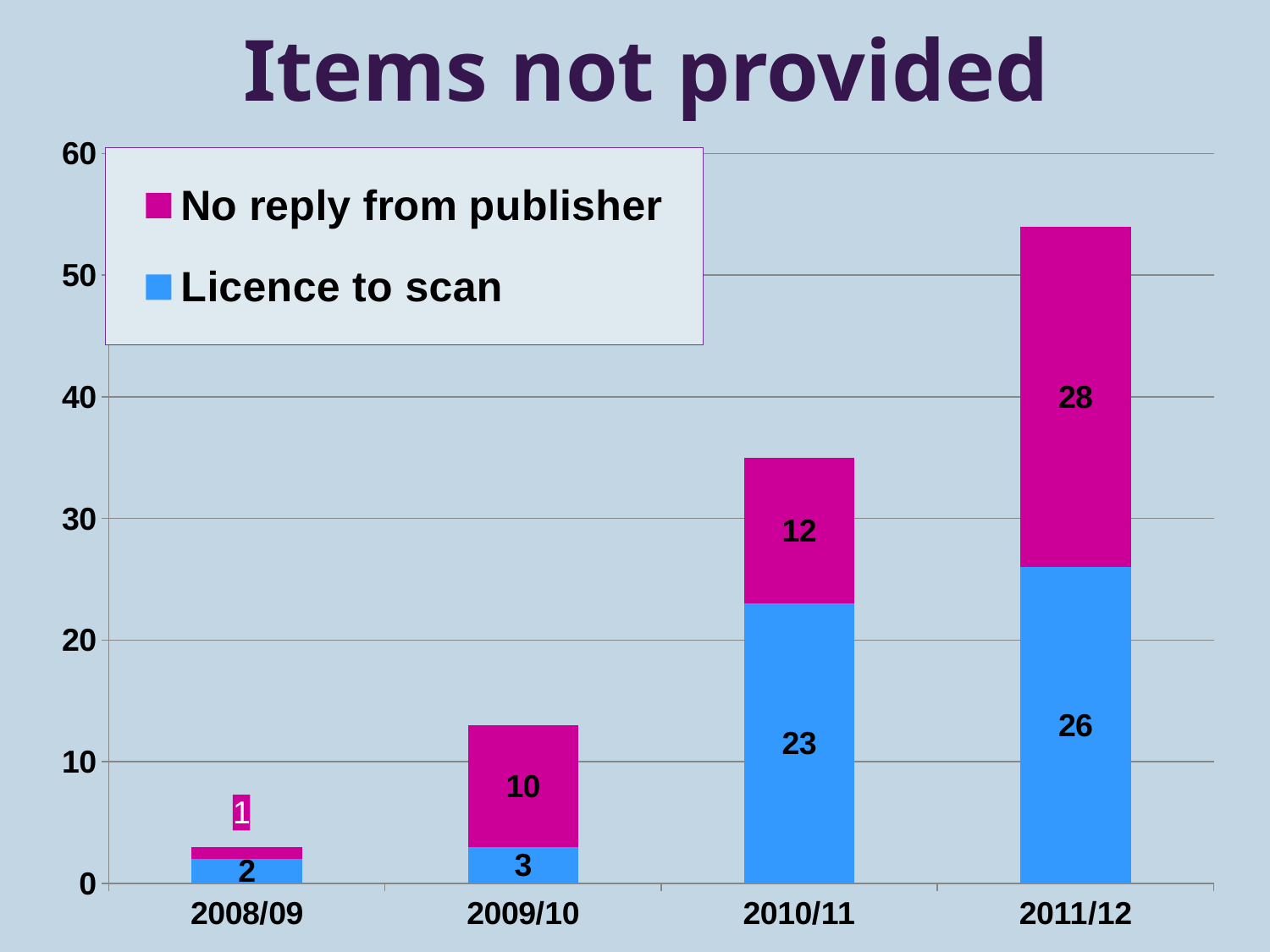
How many series does the legend list? 2 Which year has the lowest value for 'No reply from publisher'? 2008/09 Which is larger in 2009/10: 'No reply from publisher' or 'Licence to scan'? No reply from publisher What is the value for 'No reply from publisher' in 2011/12? 28 Which year has the highest value for 'Licence to scan'? 2011/12 What is the value for 'No reply from publisher' in 2008/09? 1 What kind of chart is shown on the slide? Stacked bar chart How many years are shown on the x axis? 4 What is the total of the stacked bar for 2011/12? 54 What is the value for 'Licence to scan' in 2010/11? 23 What is the difference between 'No reply from publisher' in 2011/12 and in 2010/11? 16 What is the total of the stacked bar for 2010/11? 35